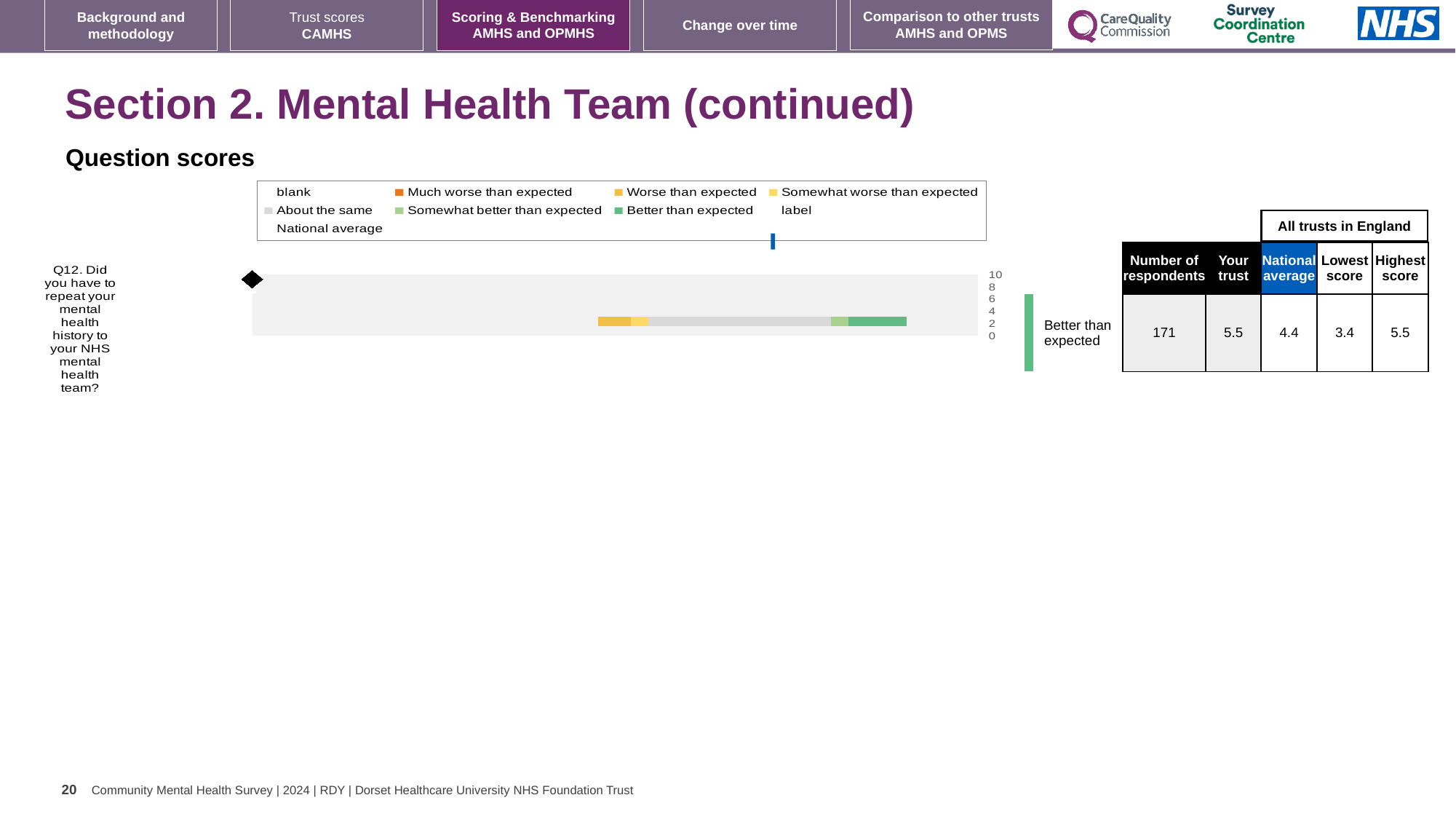
How many questions are plotted on the chart? 1 What is the 'Your trust' score for Q12? 5.5 What is the national average score for Q12? 4.4 What benchmark category is shown for Q12 next to the chart? Better than expected What kind of chart is used to show the question score for Q12? bar chart How many entries does the chart legend list? 9 What is the number of respondents for Q12? 171 Which question is plotted on the chart? Q12. Did you have to repeat your mental health history to your NHS mental health team? What is the difference between the 'Your trust' score and the national average for Q12? 1.1 Which is larger for Q12, the 'Your trust' score or the national average? Your trust What is the highest score among all trusts in England for Q12? 5.5 What is the lowest score among all trusts in England for Q12? 3.4